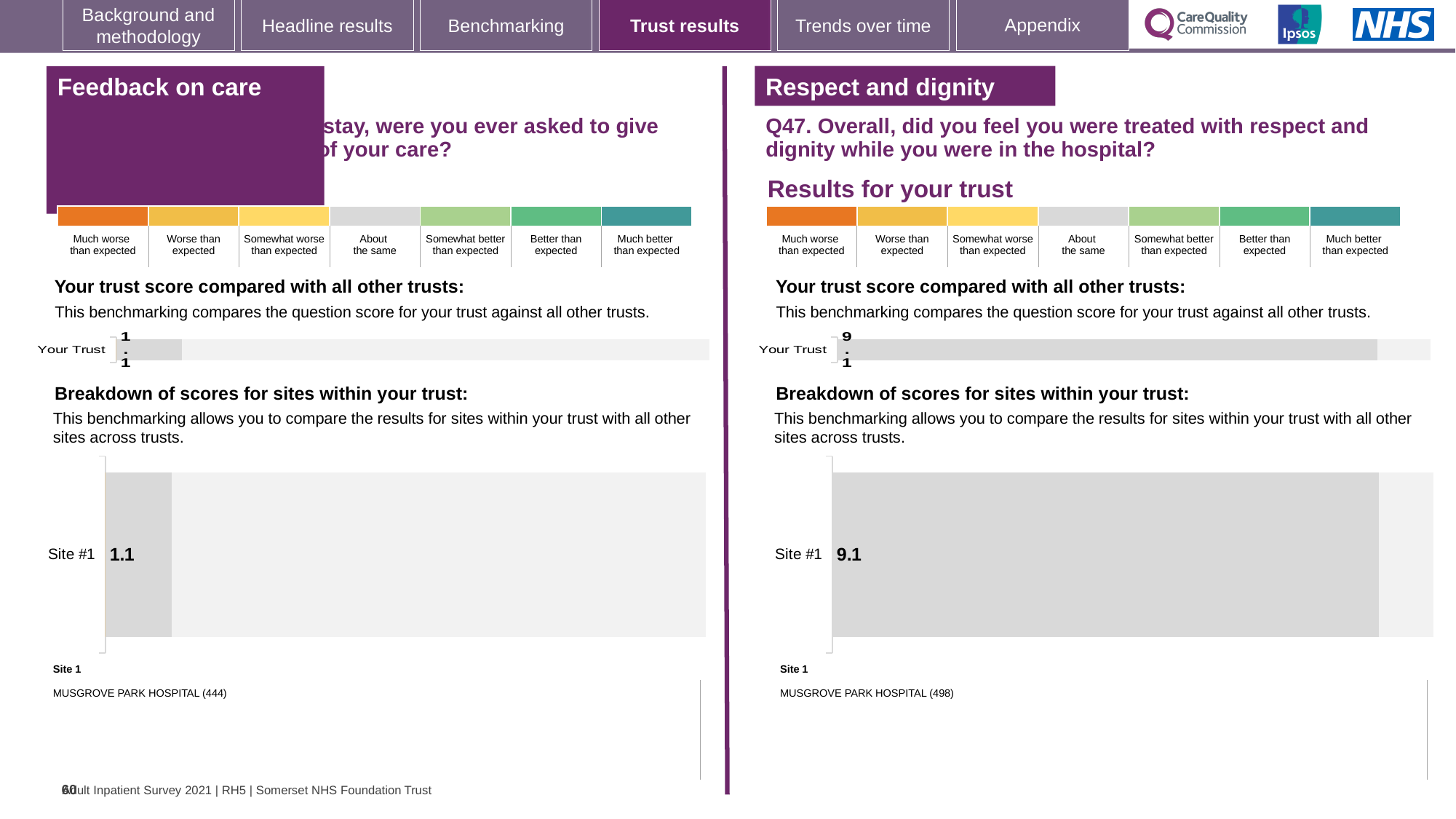
In the 'Feedback on care' section, what is the score shown for Your Trust in the trust comparison chart? 1.1 Which is larger: the Your Trust score in the 'Feedback on care' chart or the Your Trust score in the 'Respect and dignity' chart? Respect and dignity In the 'Feedback on care' section, what score is shown for Site #1 in the breakdown of sites chart? 1.1 In the 'Respect and dignity' section, what is the score shown for Your Trust in the trust comparison chart? 9.1 How many categories are shown in the colour scale legend above the 'Respect and dignity' charts? 7 What is the difference between the Site #1 score in the 'Respect and dignity' chart and the Site #1 score in the 'Feedback on care' chart? 8.0 In the 'Feedback on care' section, which site is listed as Site 1 below the breakdown chart? MUSGROVE PARK HOSPITAL (444) In the 'Respect and dignity' section, which site is listed as Site 1 below the breakdown chart? MUSGROVE PARK HOSPITAL (498) In the 'Respect and dignity' section, what score is shown for Site #1 in the breakdown of sites chart? 9.1 What kind of chart is used to show the Your Trust score in the 'Feedback on care' section? Bar chart How many sites are shown in the 'Breakdown of scores for sites within your trust' chart in the 'Respect and dignity' section? 1